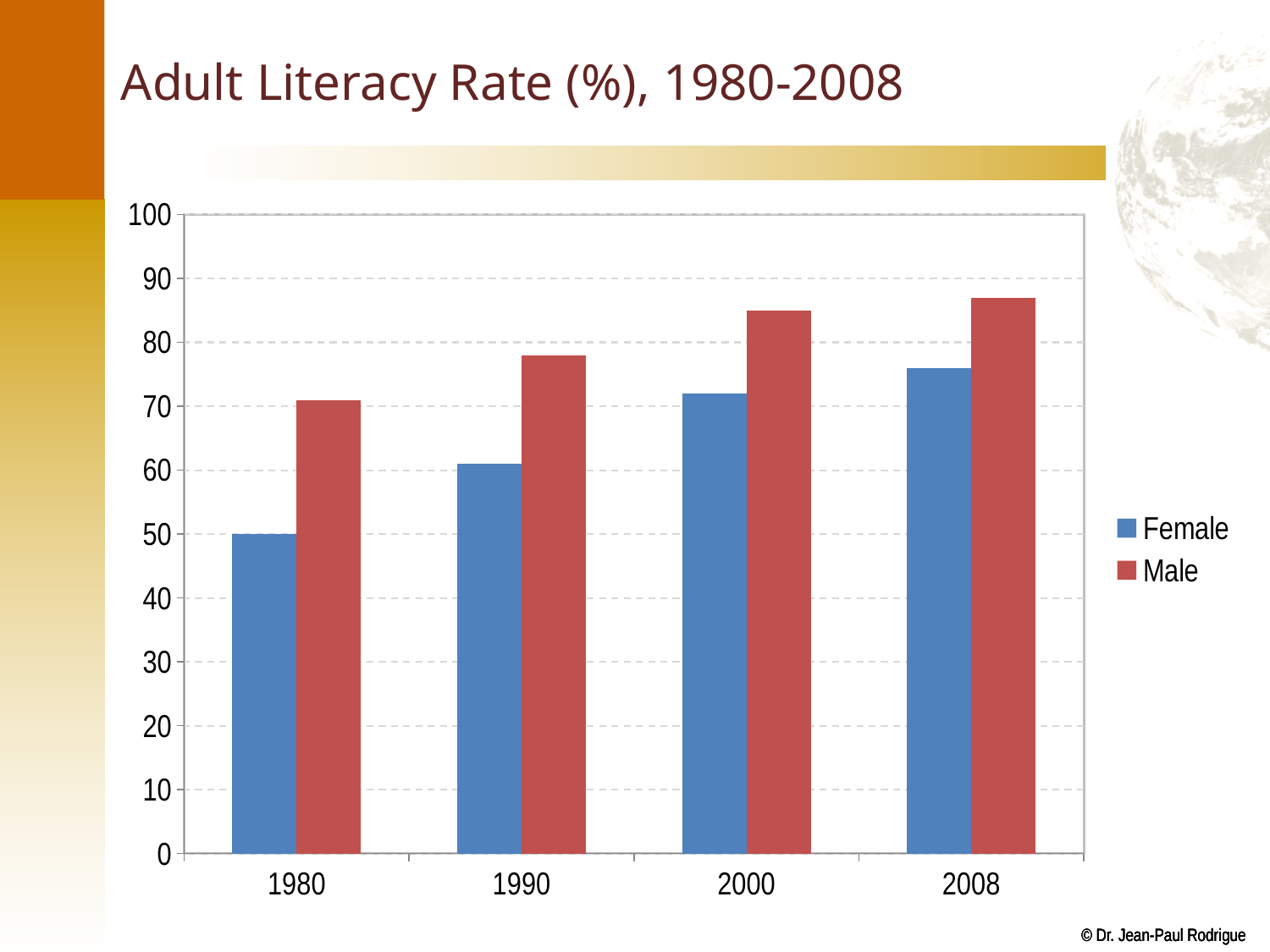
Which year has the lowest Female literacy rate? 1980 Is the Female literacy rate in 1990 greater or less than 70? less How many series does the legend list? 2 Is the Male literacy rate in 2000 greater or less than 80? greater Do the Female literacy rates rise or fall from 1980 to 2008? rise Which year has the highest Male literacy rate? 2008 In 2000, which is larger, the Male or the Female literacy rate? Male What is the Female adult literacy rate in 1980? 50 Which series is shown in red? Male What is the title of the chart? Adult Literacy Rate (%), 1980-2008 How many years are shown on the x axis? 4 What kind of chart is shown on the slide? bar chart